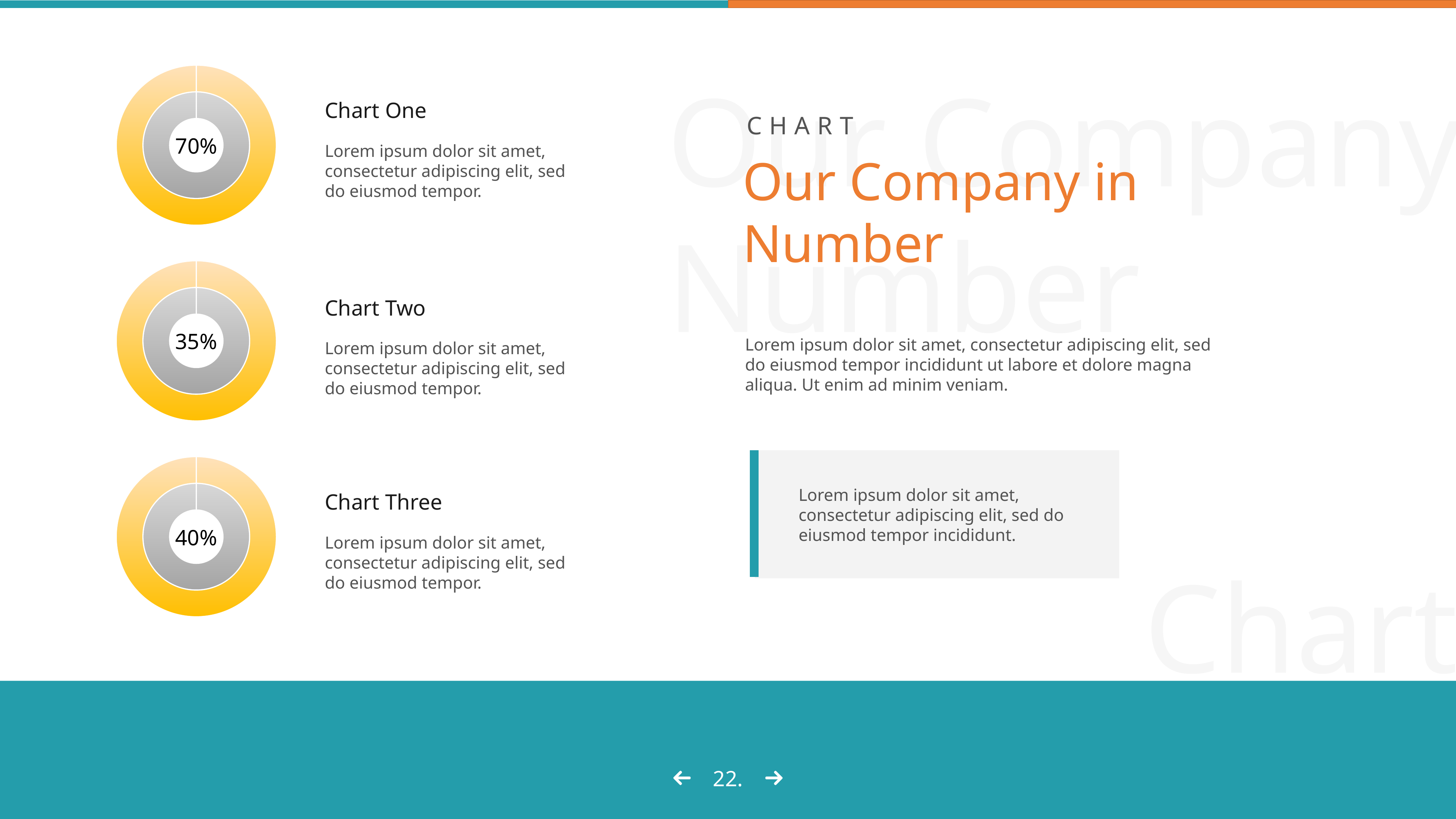
What kind of chart is used for Chart One, Chart Two and Chart Three? Donut chart What is the difference between the percentages shown for Chart One and Chart Two? 35% What is the main title of the slide above the charts' description text? Our Company in Number Which of the three charts shows the highest percentage? Chart One How many donut charts are shown on the slide? 3 Which of the three charts shows the lowest percentage? Chart Two What is the difference between the percentages shown for Chart Three and Chart Two? 5% What value is shown in the centre of the Chart One donut? 70% Which shows a larger percentage, Chart Two or Chart Three? Chart Three What value is shown in the centre of the Chart Two donut? 35% Which shows a larger percentage, Chart One or Chart Three? Chart One What value is shown in the centre of the Chart Three donut? 40%